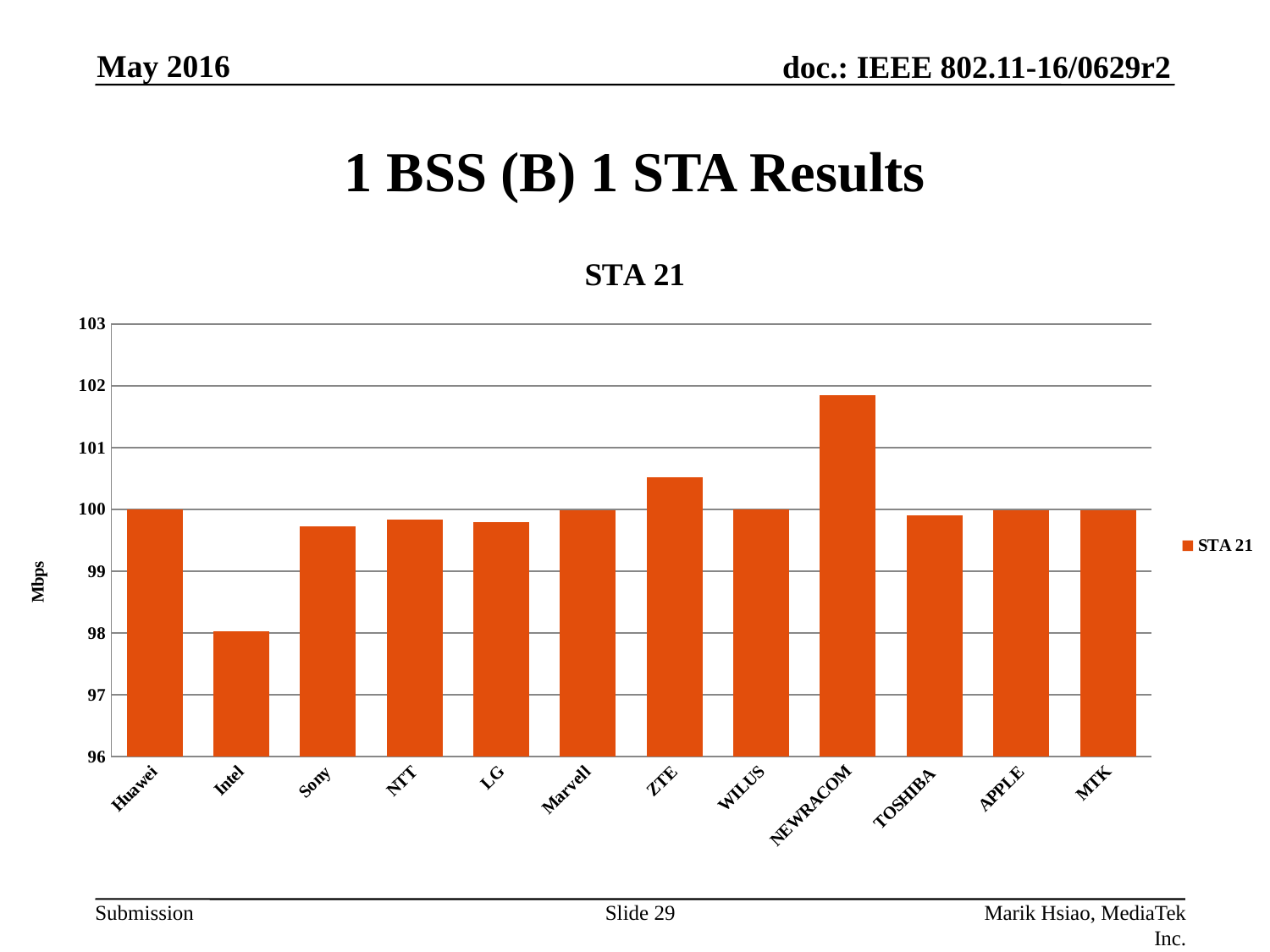
What is the title of the chart? STA 21 What is the label on the y axis of the chart? Mbps Which company has the highest value in the STA 21 chart? NEWRACOM Is the value for Sony greater or less than 100? less What kind of chart is shown on the slide? bar chart Is the value for Intel greater or less than 99? less How many companies are shown on the x axis of the chart? 12 How many series does the legend list? 1 Is the value for ZTE greater or less than 100? greater Which company has the lowest value in the STA 21 chart? Intel Which is larger, the value for ZTE or the value for Sony? ZTE